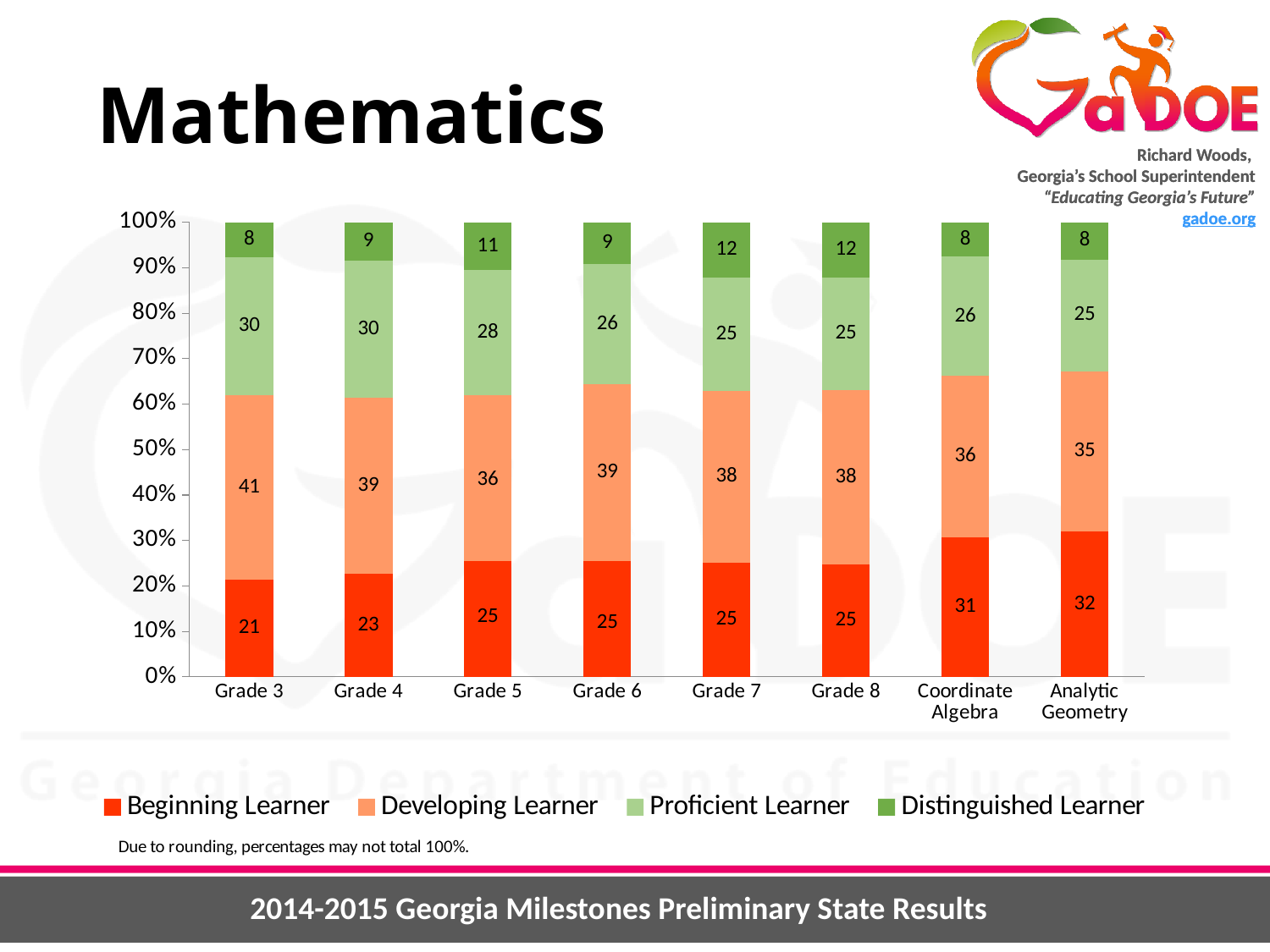
What kind of chart is shown on the slide? Stacked bar chart What is the Developing Learner value for Coordinate Algebra? 36 How many categories are shown on the x axis? 8 Which category has the lowest Beginning Learner value? Grade 3 What is the difference between the Developing Learner values for Grade 3 and Analytic Geometry? 6 How many series does the legend list? 4 What is the Distinguished Learner value for Grade 5? 11 What is the Proficient Learner value for Grade 6? 26 Which is larger, the Distinguished Learner value for Grade 7 or for Grade 4? Grade 7 Which category has the highest Developing Learner value? Grade 3 What is the Beginning Learner value for Grade 3? 21 Which category has the highest Beginning Learner value? Analytic Geometry